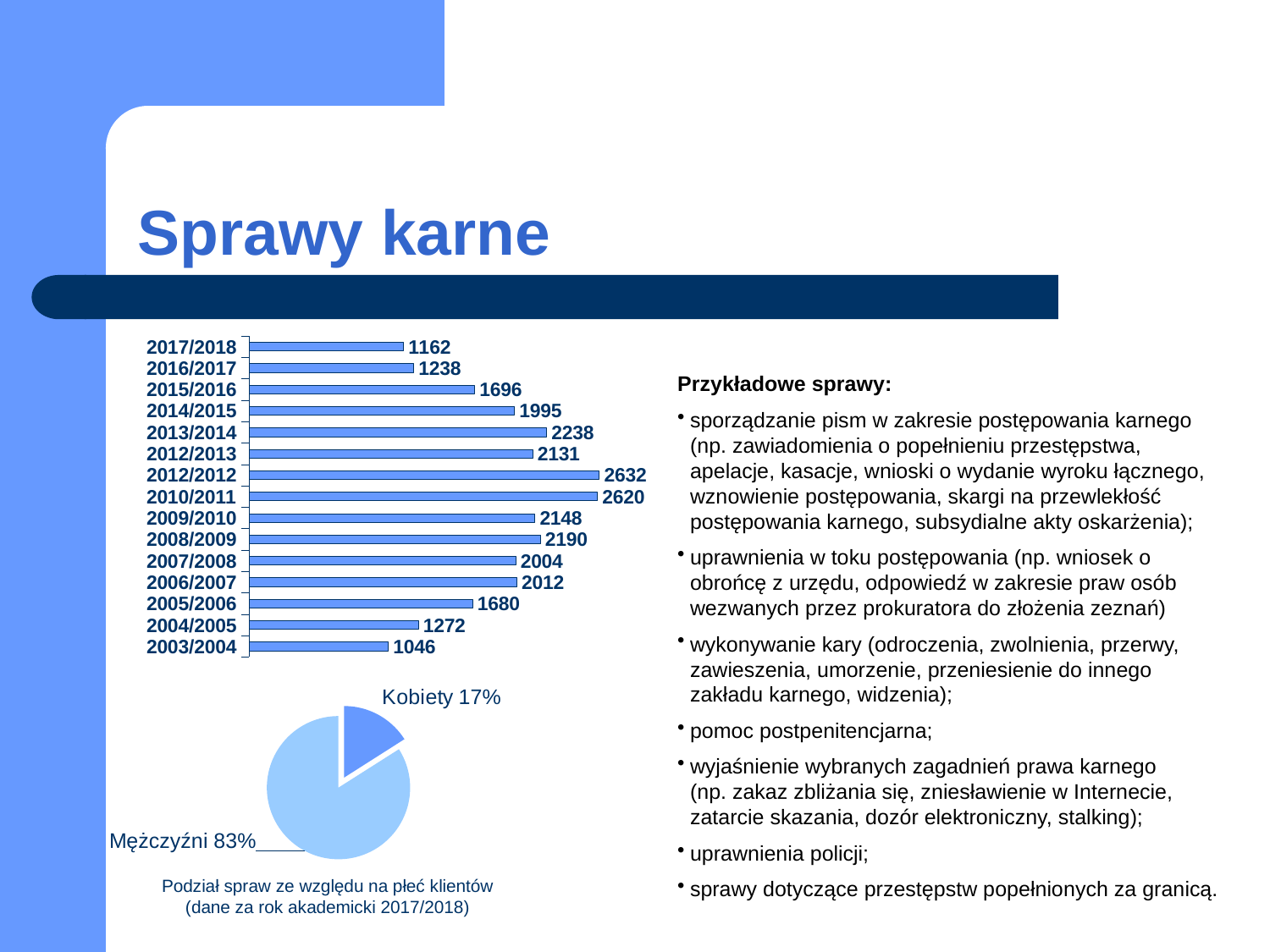
How many slices does the pie chart have? 2 In the bar chart, what is the value for 2013/2014? 2238 In the pie chart, what share is labelled Mężczyźni? 83% In the bar chart, what is the value for 2003/2004? 1046 In the pie chart, what share is labelled Kobiety? 17% In the bar chart, what is the difference between the values for 2012/2012 and 2017/2018? 1470 In the bar chart, which is larger, the value for 2015/2016 or the value for 2005/2006? 2015/2016 In the bar chart, which category has the highest value? 2012/2012 How many categories does the bar chart show? 15 In the bar chart, what is the value for 2017/2018? 1162 What kind of chart is the chart at the top left of the slide? bar chart In the bar chart, which category has the lowest value? 2003/2004